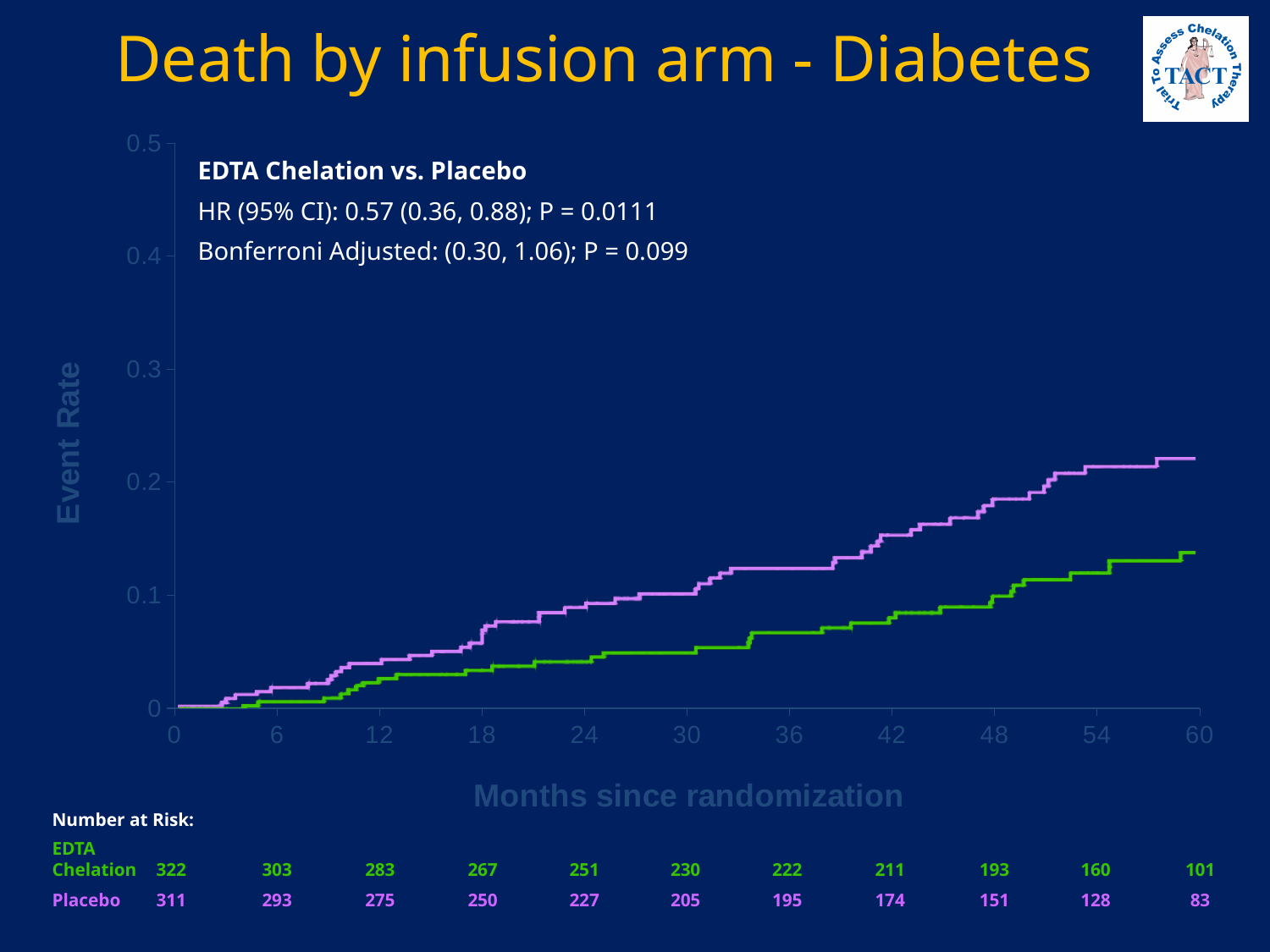
How many series (infusion arms) are plotted on the chart? 2 What is the hazard ratio for EDTA Chelation vs. Placebo shown on the chart? 0.57 What is the difference between the EDTA Chelation and Placebo numbers at risk at 60 months? 18 Is the EDTA Chelation event rate at 60 months greater or less than 0.2? less At 48 months, which arm has the higher event rate, EDTA Chelation or Placebo? Placebo What kind of chart is shown on the slide? line chart Is the EDTA Chelation event rate at 30 months greater or less than 0.1? less Is the Placebo event rate at 60 months greater or less than 0.2? greater What is the label of the x axis? Months since randomization What is the number at risk for Placebo at 36 months? 195 Do the event rate curves rise or fall as months since randomization increase? rise What is the number at risk for EDTA Chelation at 0 months? 322